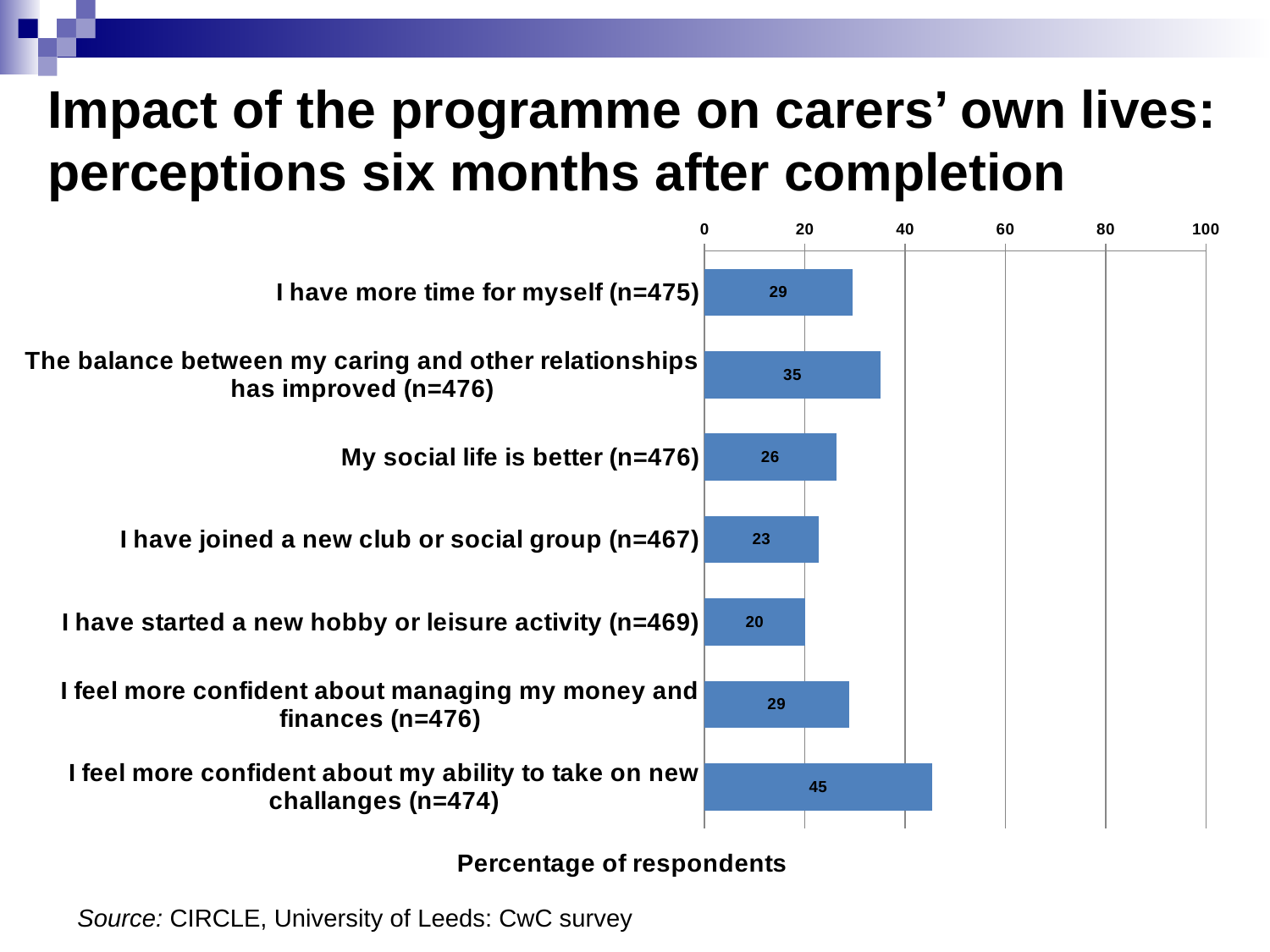
What is the value for "I feel more confident about my ability to take on new challanges (n=474)"? 45 What is the value for "I have more time for myself (n=475)"? 29 Is the value for "The balance between my caring and other relationships has improved (n=476)" greater or less than 40? less What is the difference between the values for "The balance between my caring and other relationships has improved (n=476)" and "I have joined a new club or social group (n=467)"? 12 Which is larger: the value for "My social life is better (n=476)" or the value for "I feel more confident about managing my money and finances (n=476)"? I feel more confident about managing my money and finances (n=476) What is the value for "My social life is better (n=476)"? 26 Which category has the highest value? I feel more confident about my ability to take on new challanges (n=474) What is the value for "I have started a new hobby or leisure activity (n=469)"? 20 What is the label of the horizontal axis? Percentage of respondents Which category has the lowest value? I have started a new hobby or leisure activity (n=469) What kind of chart is shown on the slide? bar chart How many categories are shown in the chart? 7